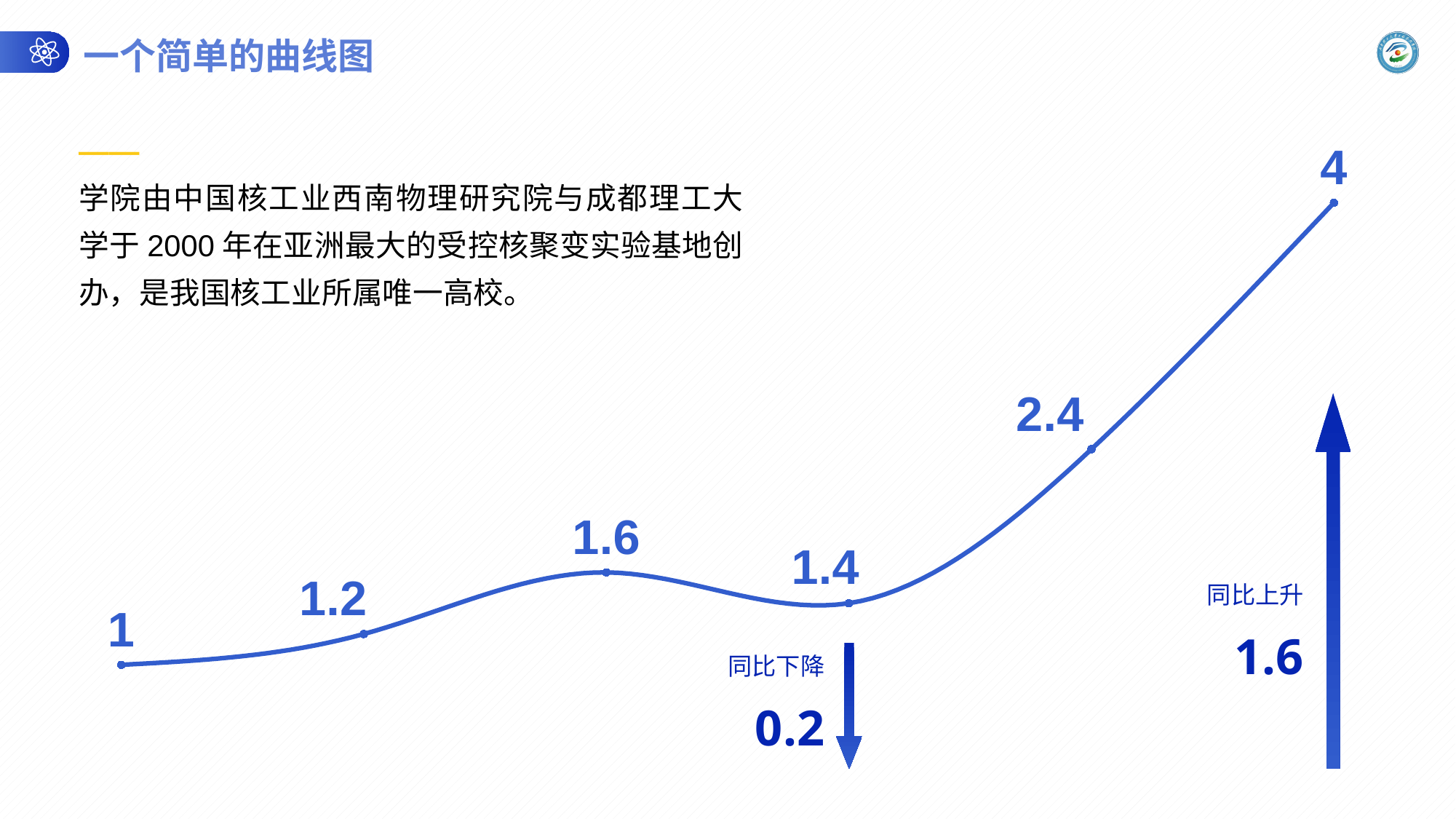
What is the lowest value plotted on the line chart? 1 What is the difference between the last point (4) and the fifth point (2.4) on the line chart? 1.6 How many data points are plotted on the line chart? 6 What is the value of the first (leftmost) point on the line chart? 1 What is the difference between the third point (1.6) and the fourth point (1.4) on the line chart? 0.2 What kind of chart is shown on the slide? line chart Which is larger on the line chart, the second point or the fourth point? the fourth point (1.4) What is the value of the third point from the left on the line chart? 1.6 What is the title of the slide containing the line chart? 一个简单的曲线图 What is the highest value plotted on the line chart? 4 What is the value of the fifth point from the left on the line chart? 2.4 What is the value of the last (rightmost) point on the line chart? 4